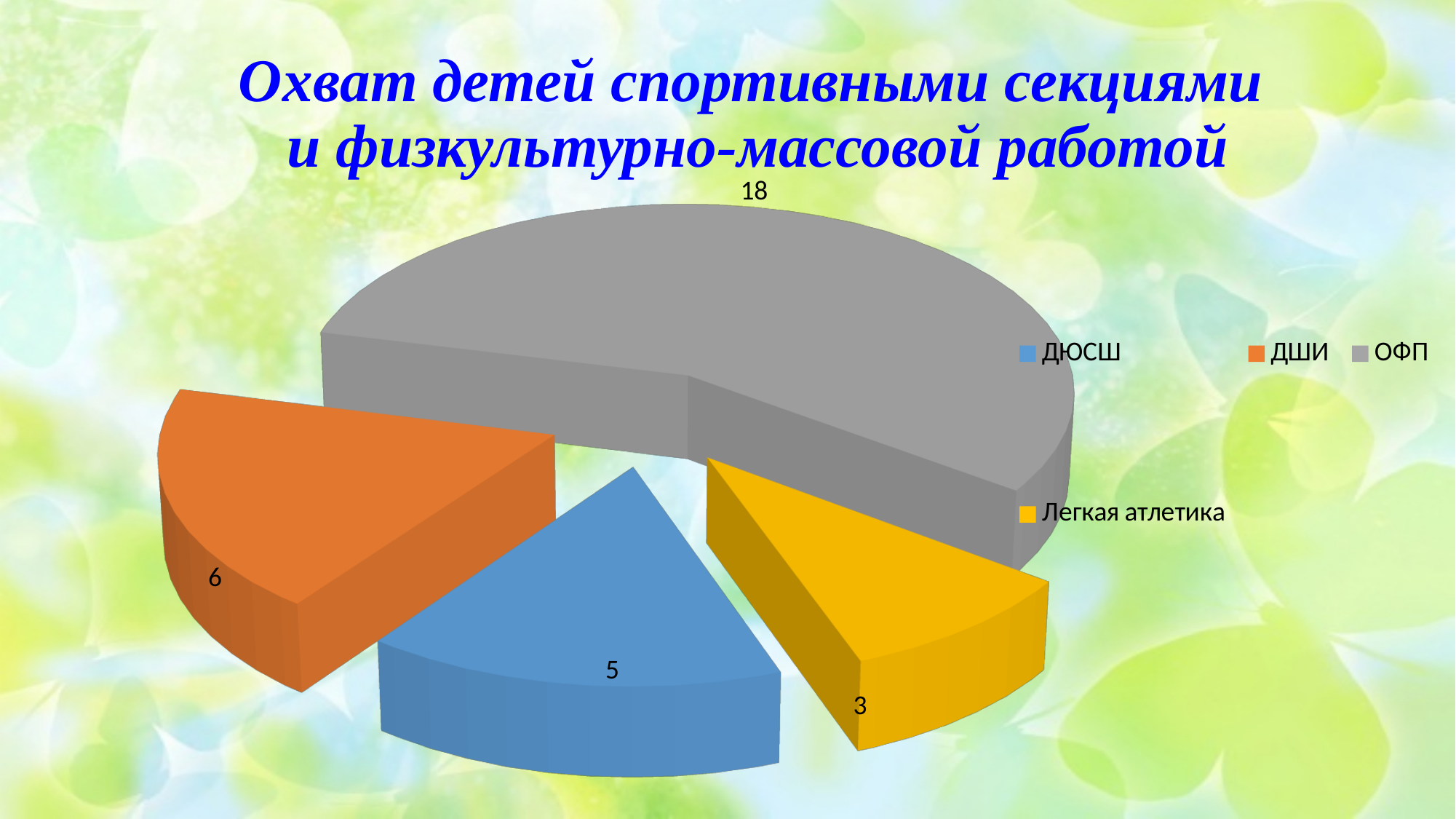
How many slices does the pie chart have? 4 Which category has the largest slice? ОФП Which category has the smallest slice? Легкая атлетика What colour is the slice for Легкая атлетика? Yellow What is the value for ДЮСШ? 5 What is the value for ДШИ? 6 What is the difference between the values for ОФП and ДШИ? 12 What kind of chart is shown on the slide? Pie chart What is the total of all the slices in the pie chart? 32 What is the value for ОФП? 18 What is the value for Легкая атлетика? 3 Which is larger, ДШИ or ДЮСШ? ДШИ